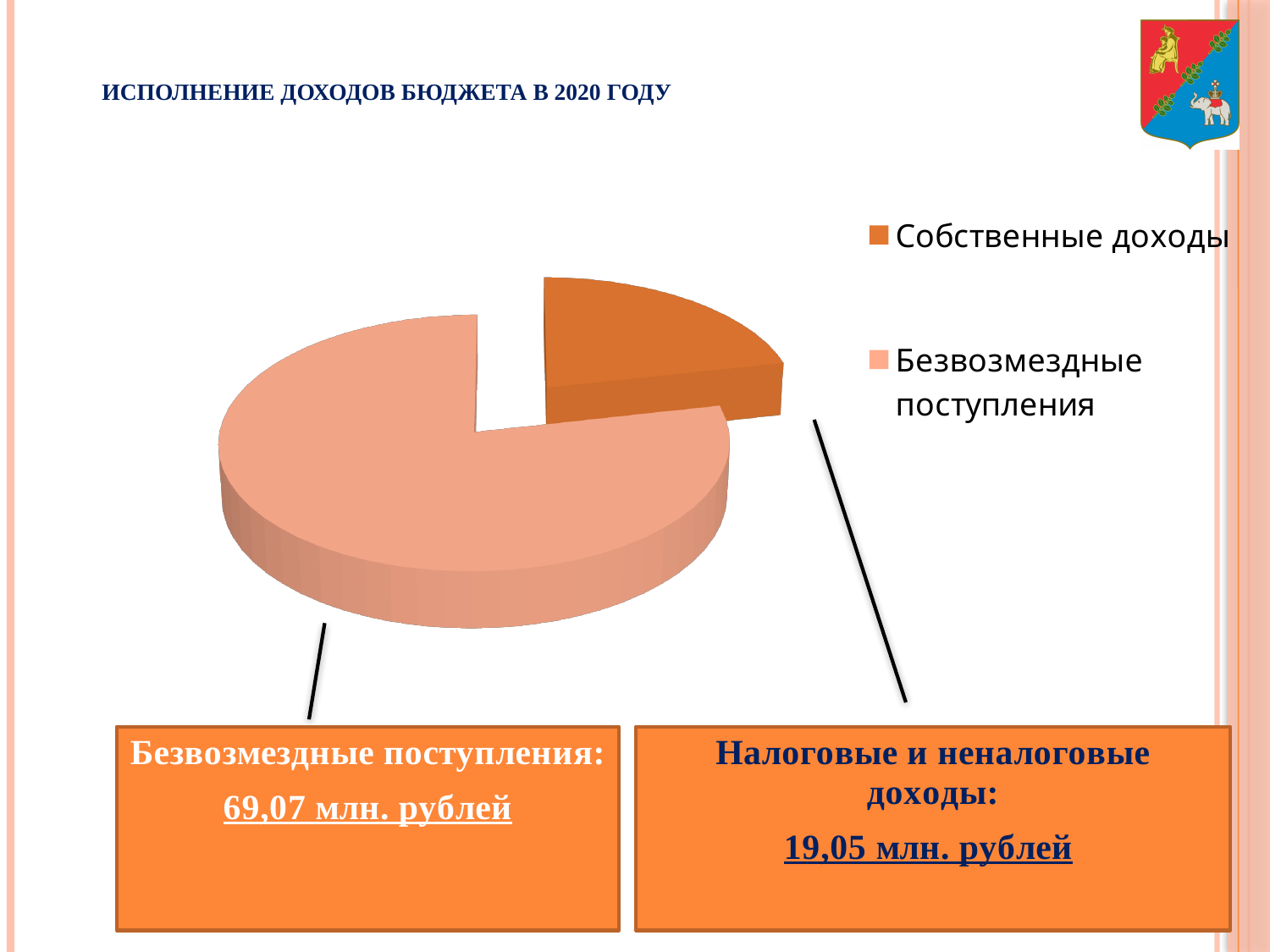
What kind of chart is shown on the slide? Pie chart How many entries does the legend of the pie chart list? 2 What value is given for Налоговые и неналоговые доходы in the callout box below the chart? 19,05 млн. рублей By how much do Безвозмездные поступления (69,07 млн. рублей) exceed Налоговые и неналоговые доходы (19,05 млн. рублей)? 50,02 млн. рублей What value is given for Безвозмездные поступления in the callout box below the chart? 69,07 млн. рублей Which is larger: Безвозмездные поступления or Собственные доходы? Безвозмездные поступления Which category takes the largest slice of the pie chart? Безвозмездные поступления Which legend entry is shown in the darker orange colour? Собственные доходы What is the total of the two values shown in the callout boxes, 69,07 and 19,05 млн. рублей? 88,12 млн. рублей Which category takes the smallest slice of the pie chart? Собственные доходы What is the title of the slide containing the pie chart? ИСПОЛНЕНИЕ ДОХОДОВ БЮДЖЕТА В 2020 ГОДУ How many slices does the pie chart have? 2